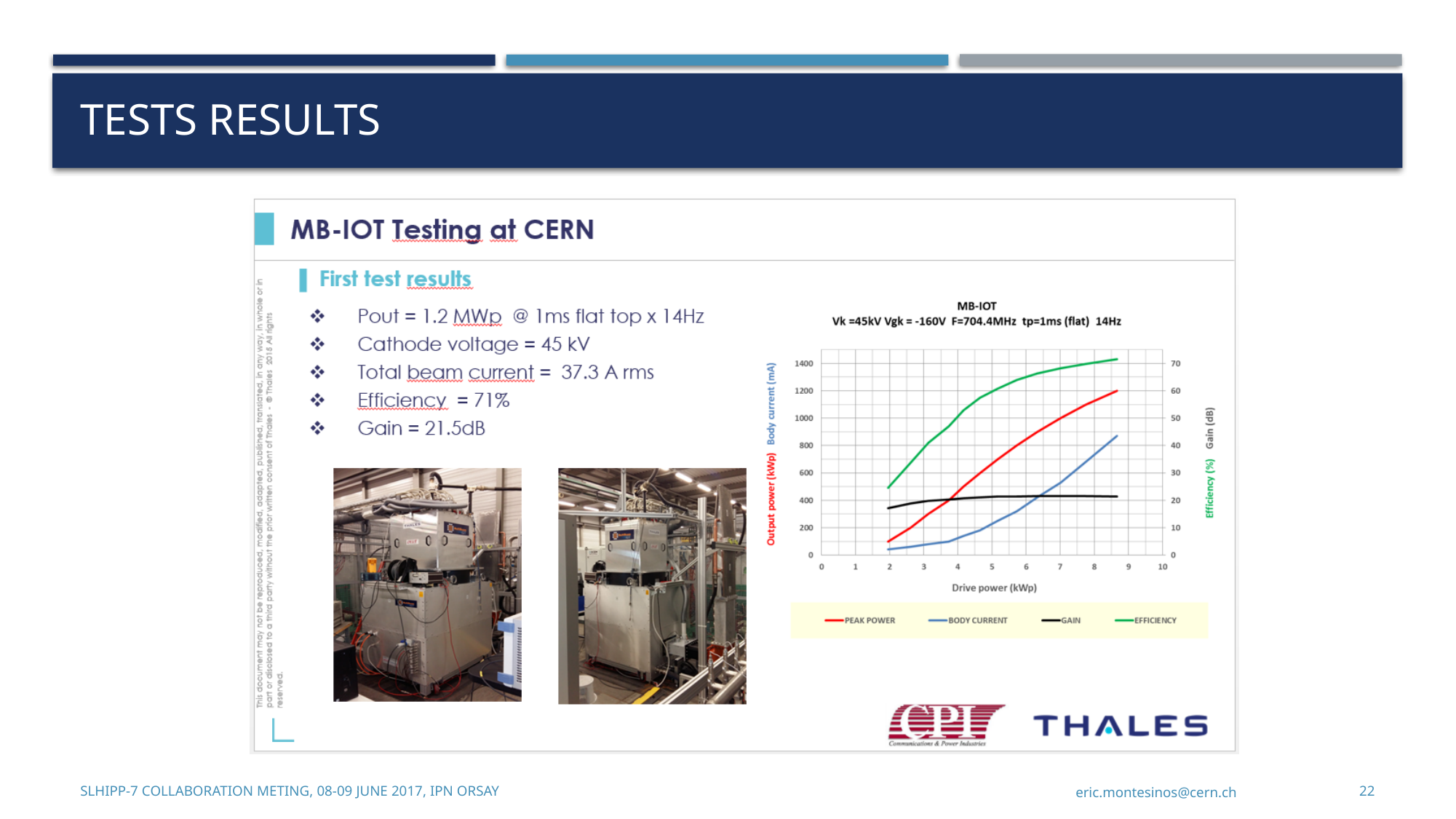
Does the BODY CURRENT curve rise or fall as drive power increases? rise What quantity is plotted on the x axis of the chart? Drive power (kWp) Is the GAIN value at a drive power of 6 kWp greater or less than 30 dB? less Is the BODY CURRENT value at a drive power of 2 kWp greater or less than 200 mA? less Does the EFFICIENCY curve rise or fall as drive power increases? rise Does the PEAK POWER curve rise or fall as drive power increases? rise At a drive power of 8 kWp, which is larger on the left axis: PEAK POWER or BODY CURRENT? PEAK POWER Is the PEAK POWER value at the highest plotted drive power greater or less than 1000 kWp? greater What is the title of the chart? MB-IOT What kind of chart is shown on the slide? line chart How many series does the chart legend list? 4